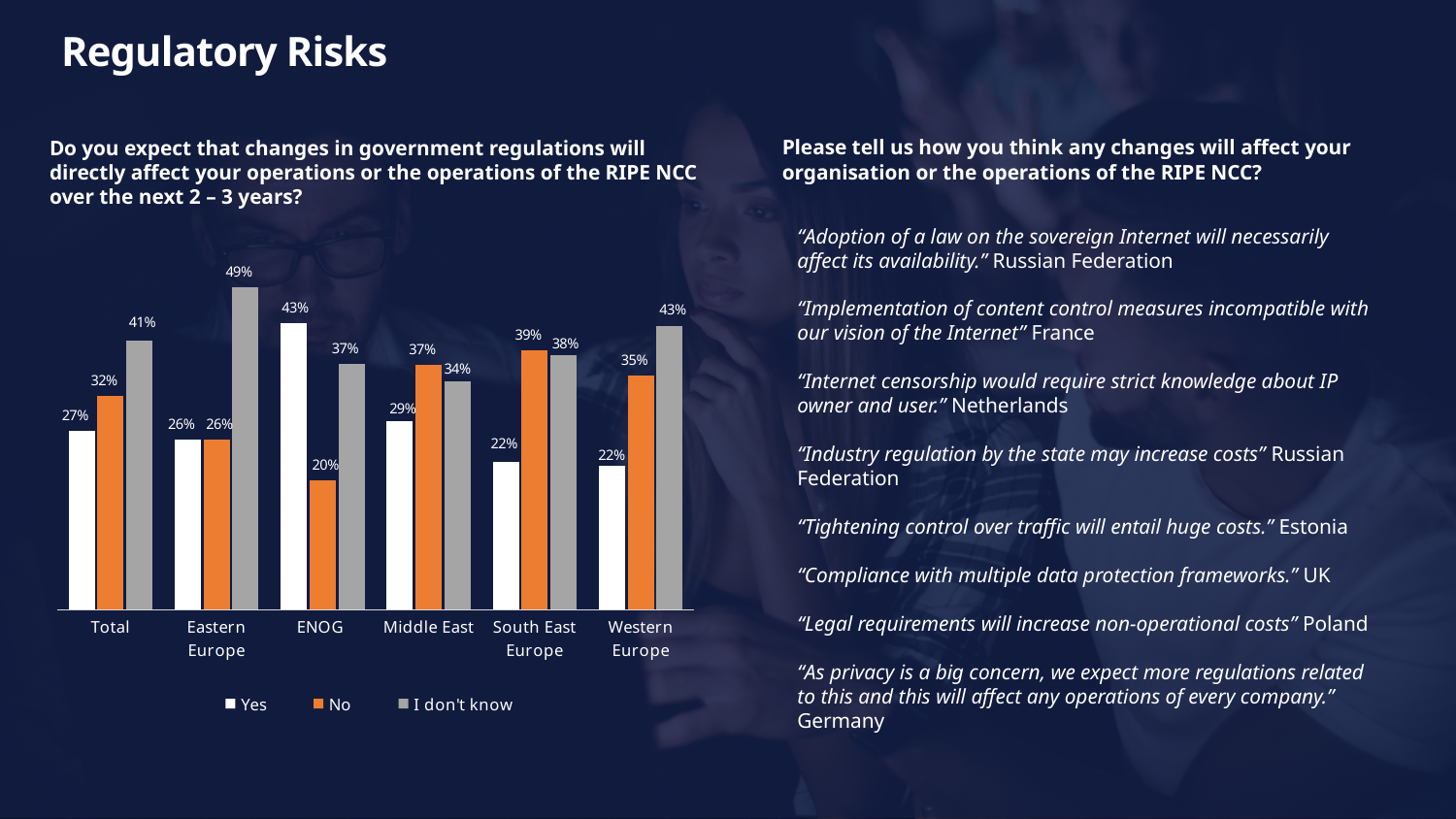
What is the difference between the "I don't know" and "Yes" values for Total? 14% How many series does the chart legend list? 3 Which colour represents the "No" series in the chart? Orange What is the "No" value for ENOG? 20% For South East Europe, which is larger: the "No" value or the "Yes" value? No What is the "I don't know" value for Eastern Europe? 49% What is the "Yes" value for Middle East? 29% What type of chart is shown on the slide? Bar chart What percentage of Total respondents answered "Yes"? 27% How many regions (categories) are shown on the x axis of the chart? 6 Which region has the highest "Yes" value? ENOG Which region has the lowest "No" value? ENOG